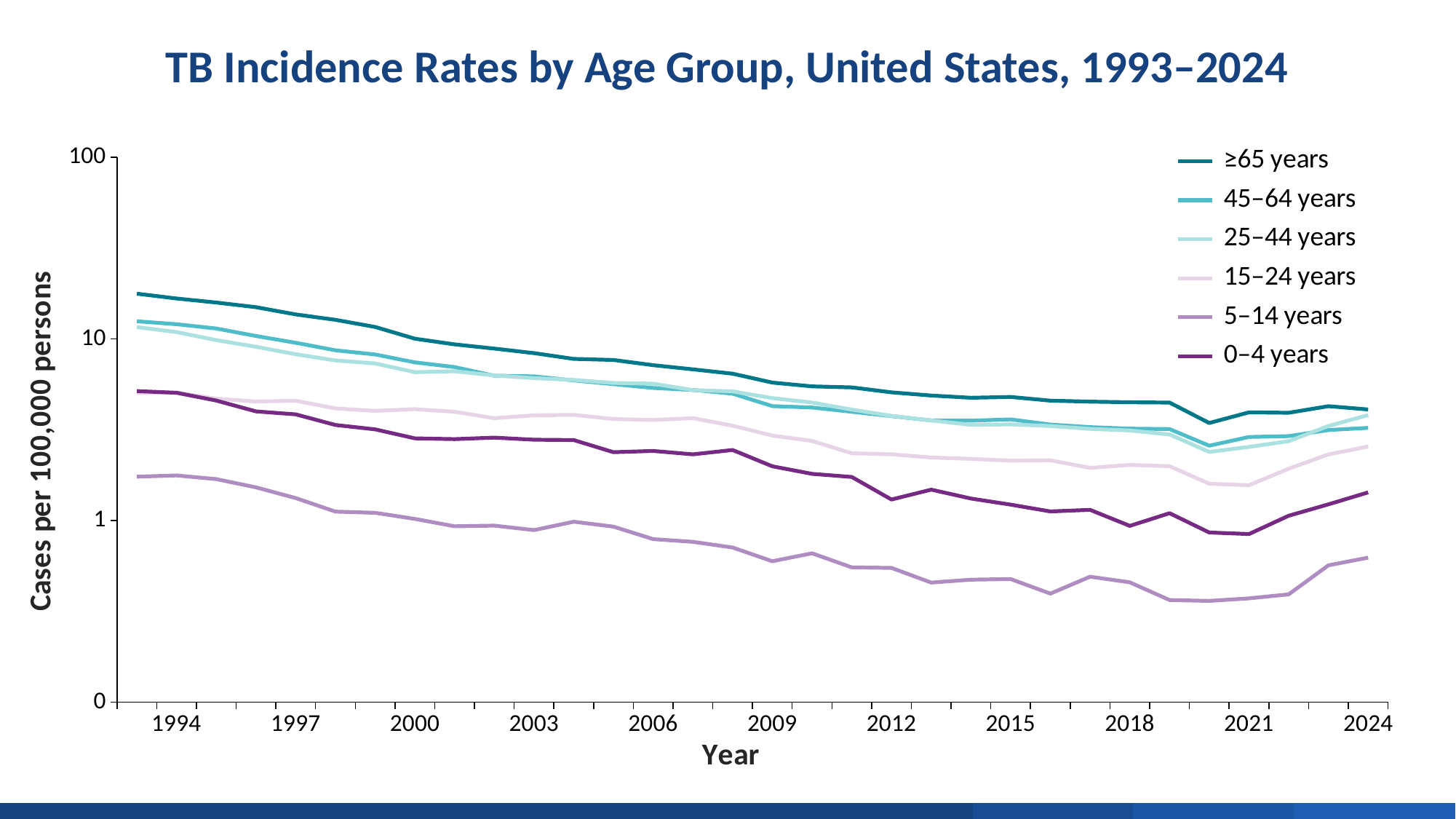
How many age groups does the legend list? 6 Is the value for ≥65 years in 1994 greater or less than 10? greater Is the value for 45–64 years in 2000 greater or less than 10? less What is the label on the vertical axis? Cases per 100,000 persons Does the TB incidence rate for ≥65 years rise or fall from 1993 to 2020? fall Is the value for 0–4 years in 2024 greater or less than 1? greater What kind of chart is shown on the slide? line chart What is the title of the chart? TB Incidence Rates by Age Group, United States, 1993–2024 In 2024, which has the larger TB incidence rate: 0–4 years or 5–14 years? 0–4 years Which age group has the lowest TB incidence rate in 2024? 5–14 years Which age group has the highest TB incidence rate in 1994? ≥65 years